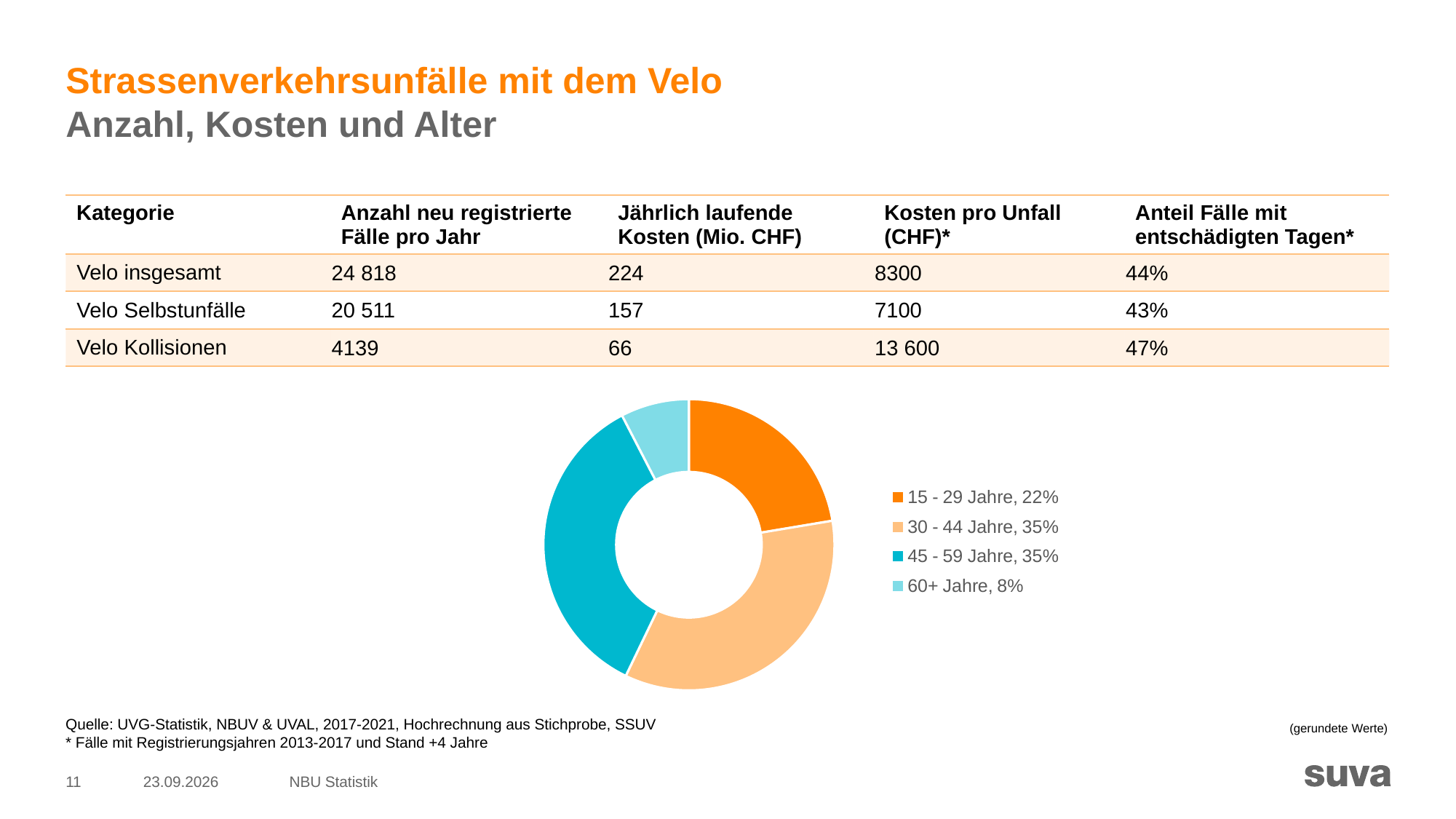
Which slice is larger, 30 - 44 Jahre or 15 - 29 Jahre? 30 - 44 Jahre Which slice is larger, 15 - 29 Jahre or 60+ Jahre? 15 - 29 Jahre How many age groups are shown in the doughnut chart? 4 What kind of chart is shown below the table? Doughnut (pie) chart What share of the doughnut chart is the 60+ Jahre slice? 8% Which age group has the smallest slice in the doughnut chart? 60+ Jahre Which age group is shown in dark orange in the doughnut chart? 15 - 29 Jahre By how many percentage points does the 15 - 29 Jahre slice exceed the 60+ Jahre slice? 14 percentage points What percentage does the legend give for 45 - 59 Jahre? 35% By how many percentage points does the 45 - 59 Jahre slice exceed the 15 - 29 Jahre slice? 13 percentage points What share of the doughnut chart is the 15 - 29 Jahre slice? 22% What percentage does the legend give for 30 - 44 Jahre? 35%